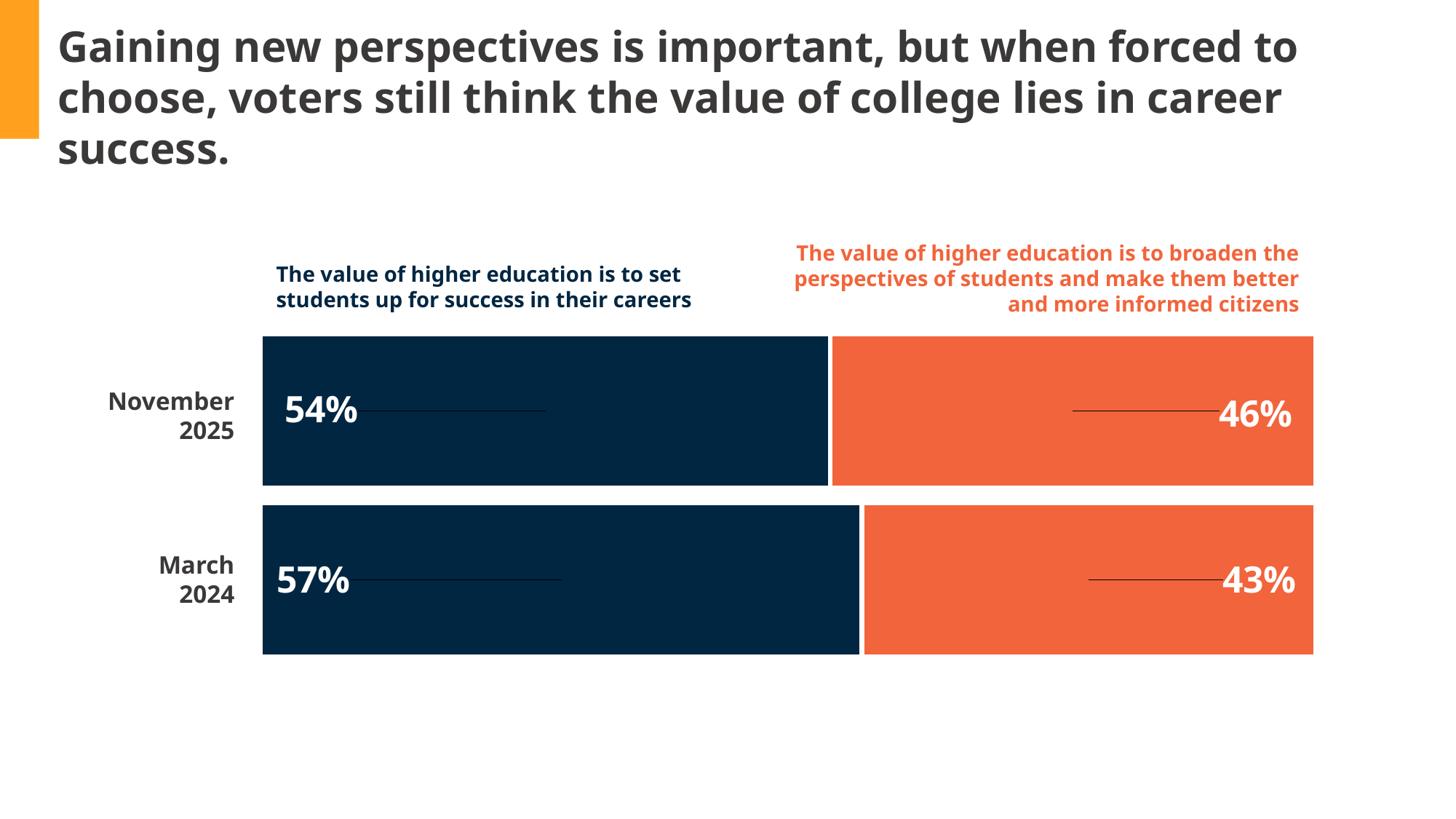
What is the difference between the share choosing 'set students up for success in their careers' and the share choosing 'broaden the perspectives of students' in November 2025? 8 percentage points What is the total of the two segments in the November 2025 bar? 100% What percentage of voters in November 2025 said the value of higher education is to broaden the perspectives of students and make them better and more informed citizens? 46% How many survey waves (categories) are shown in the chart? 2 How many response options (series) does the chart show? 2 What percentage of voters in November 2025 said the value of higher education is to set students up for success in their careers? 54% In which survey wave was the share choosing 'set students up for success in their careers' higher, November 2025 or March 2024? March 2024 Which colour represents the response 'The value of higher education is to broaden the perspectives of students and make them better and more informed citizens'? Orange What type of chart is shown on the slide? Stacked bar chart By how many percentage points did the share choosing 'set students up for success in their careers' change from March 2024 to November 2025? 3 percentage points What percentage of voters in March 2024 said the value of higher education is to broaden the perspectives of students and make them better and more informed citizens? 43% What percentage of voters in March 2024 said the value of higher education is to set students up for success in their careers? 57%